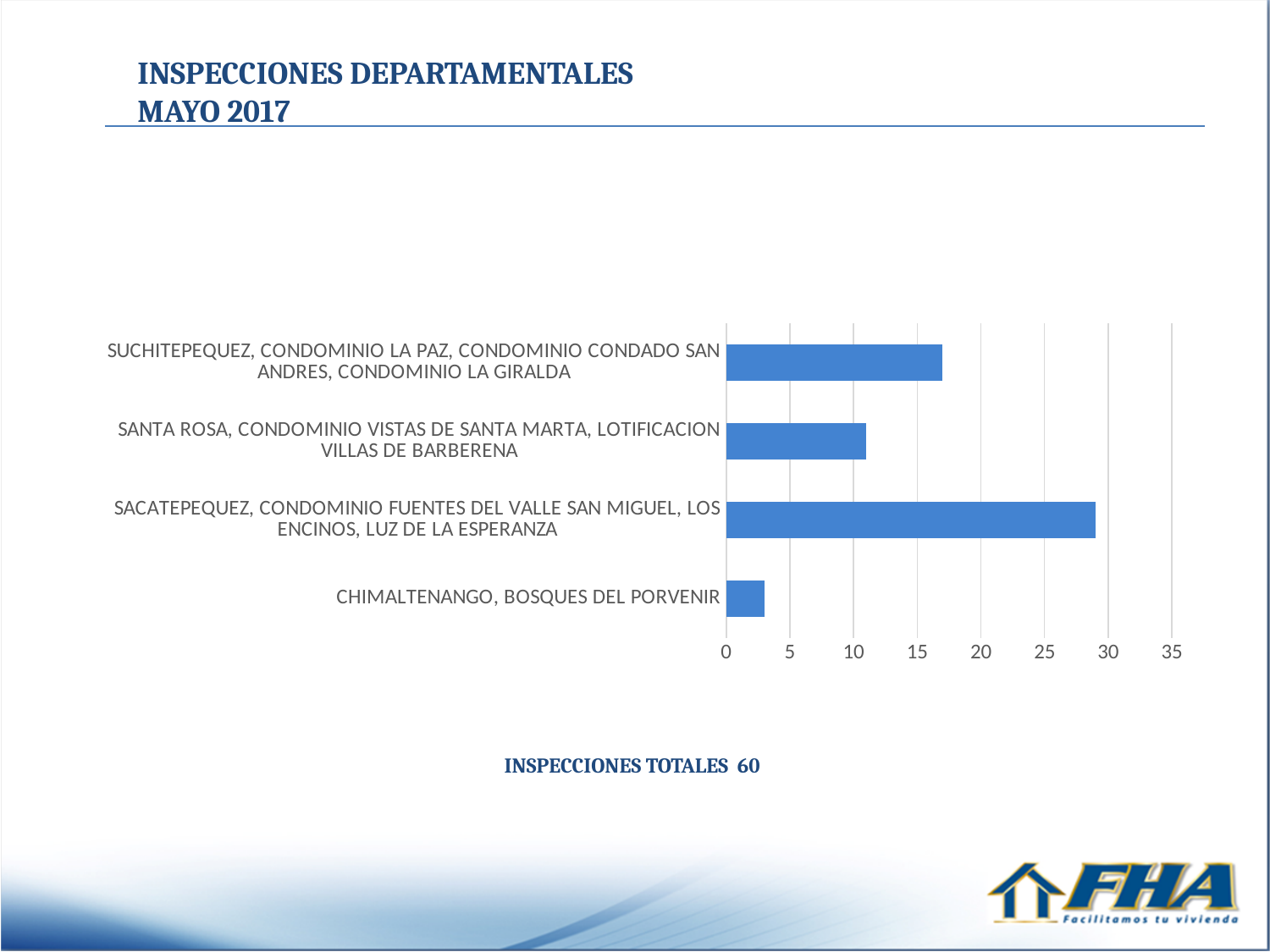
Is the value for SACATEPEQUEZ, CONDOMINIO FUENTES DEL VALLE SAN MIGUEL, LOS ENCINOS, LUZ DE LA ESPERANZA greater or less than 25? greater Is the value for CHIMALTENANGO, BOSQUES DEL PORVENIR greater or less than 5? less How many categories are plotted in the chart? 4 Which has a larger value: CHIMALTENANGO, BOSQUES DEL PORVENIR or SANTA ROSA, CONDOMINIO VISTAS DE SANTA MARTA, LOTIFICACION VILLAS DE BARBERENA? SANTA ROSA, CONDOMINIO VISTAS DE SANTA MARTA, LOTIFICACION VILLAS DE BARBERENA What total number of inspections is stated below the chart? 60 Which category has the lowest value in the chart? CHIMALTENANGO, BOSQUES DEL PORVENIR Which has a larger value: SUCHITEPEQUEZ, CONDOMINIO LA PAZ, CONDOMINIO CONDADO SAN ANDRES, CONDOMINIO LA GIRALDA or SANTA ROSA, CONDOMINIO VISTAS DE SANTA MARTA, LOTIFICACION VILLAS DE BARBERENA? SUCHITEPEQUEZ, CONDOMINIO LA PAZ, CONDOMINIO CONDADO SAN ANDRES, CONDOMINIO LA GIRALDA Which category has the highest value in the chart? SACATEPEQUEZ, CONDOMINIO FUENTES DEL VALLE SAN MIGUEL, LOS ENCINOS, LUZ DE LA ESPERANZA What is the maximum value shown on the chart's horizontal axis? 35 Is the value for SANTA ROSA, CONDOMINIO VISTAS DE SANTA MARTA, LOTIFICACION VILLAS DE BARBERENA greater or less than 10? greater What kind of chart is shown on the slide? bar chart